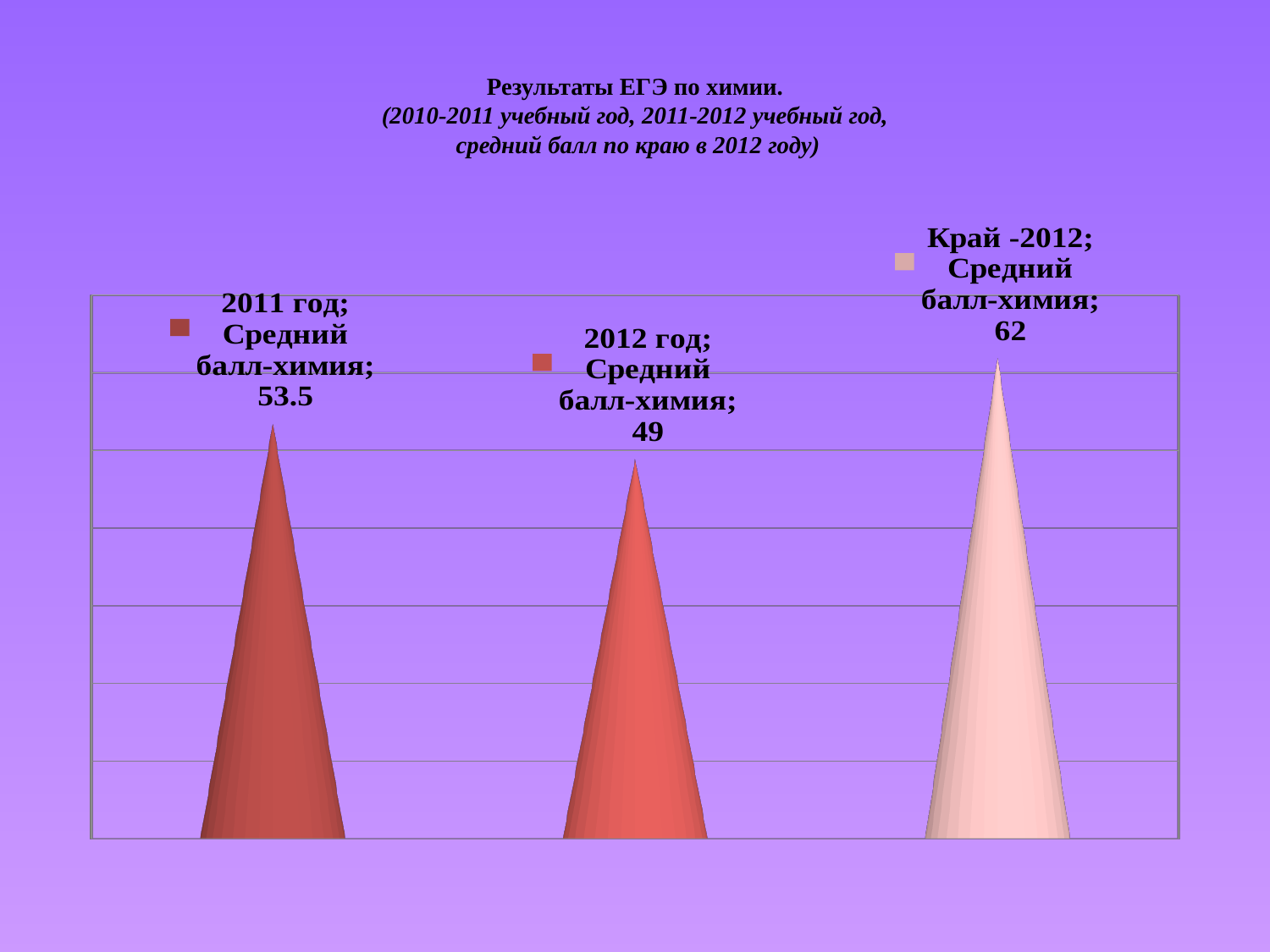
Which category has the highest value on the chart? Край -2012 What kind of chart is shown on the slide? bar chart What is the difference between the value for Край -2012 and the value for 2012 год? 13 What is the average chemistry score shown for 2012 год? 49 What is the difference between the value for 2011 год and the value for 2012 год? 4.5 What is the value shown for Край -2012? 62 What is the title of the chart on the slide? Результаты ЕГЭ по химии. What is the name of the data series shown in the data labels? Средний балл-химия Which is larger, the value for 2011 год or the value for 2012 год? 2011 год Which category has the lowest value on the chart? 2012 год How many categories are plotted on the chart? 3 What is the average chemistry score shown for 2011 год? 53.5